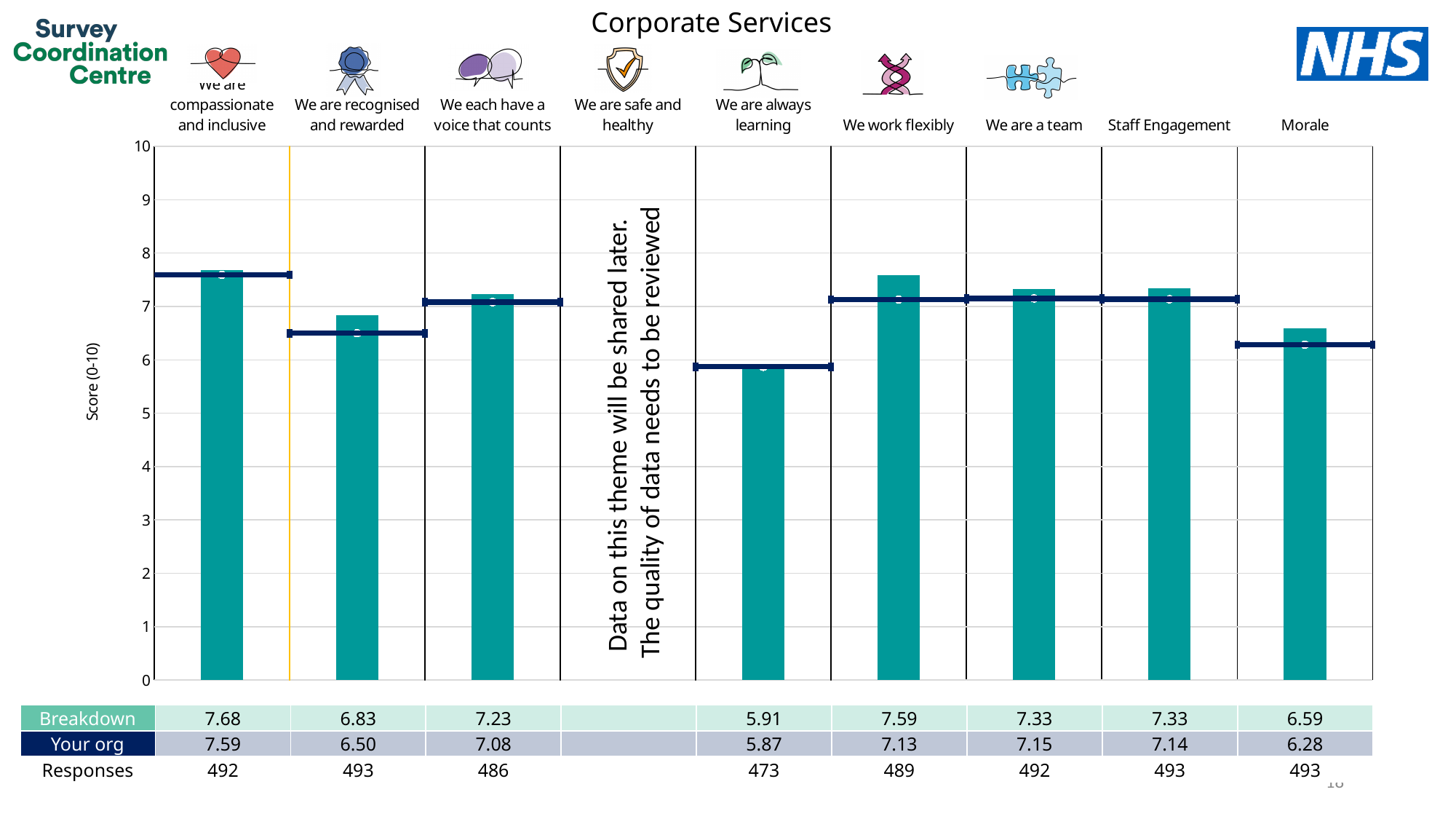
What kind of chart is shown on the slide? bar chart What is the title of the chart? Corporate Services What is the difference between the Breakdown score and the 'Your org' score for 'We are recognised and rewarded'? 0.33 Which theme has the lowest Breakdown score? We are always learning What is the Breakdown score for 'We are always learning'? 5.91 Which has the higher Breakdown score: 'We work flexibly' or 'We are a team'? We work flexibly How many themes have a bar plotted on the chart? 8 Which theme has the highest Breakdown score? We are compassionate and inclusive How many responses are recorded for 'We each have a voice that counts'? 486 Which theme has no data shown on the chart? We are safe and healthy Is the Breakdown bar for Morale greater or less than 7? less What is the 'Your org' score for Morale? 6.28